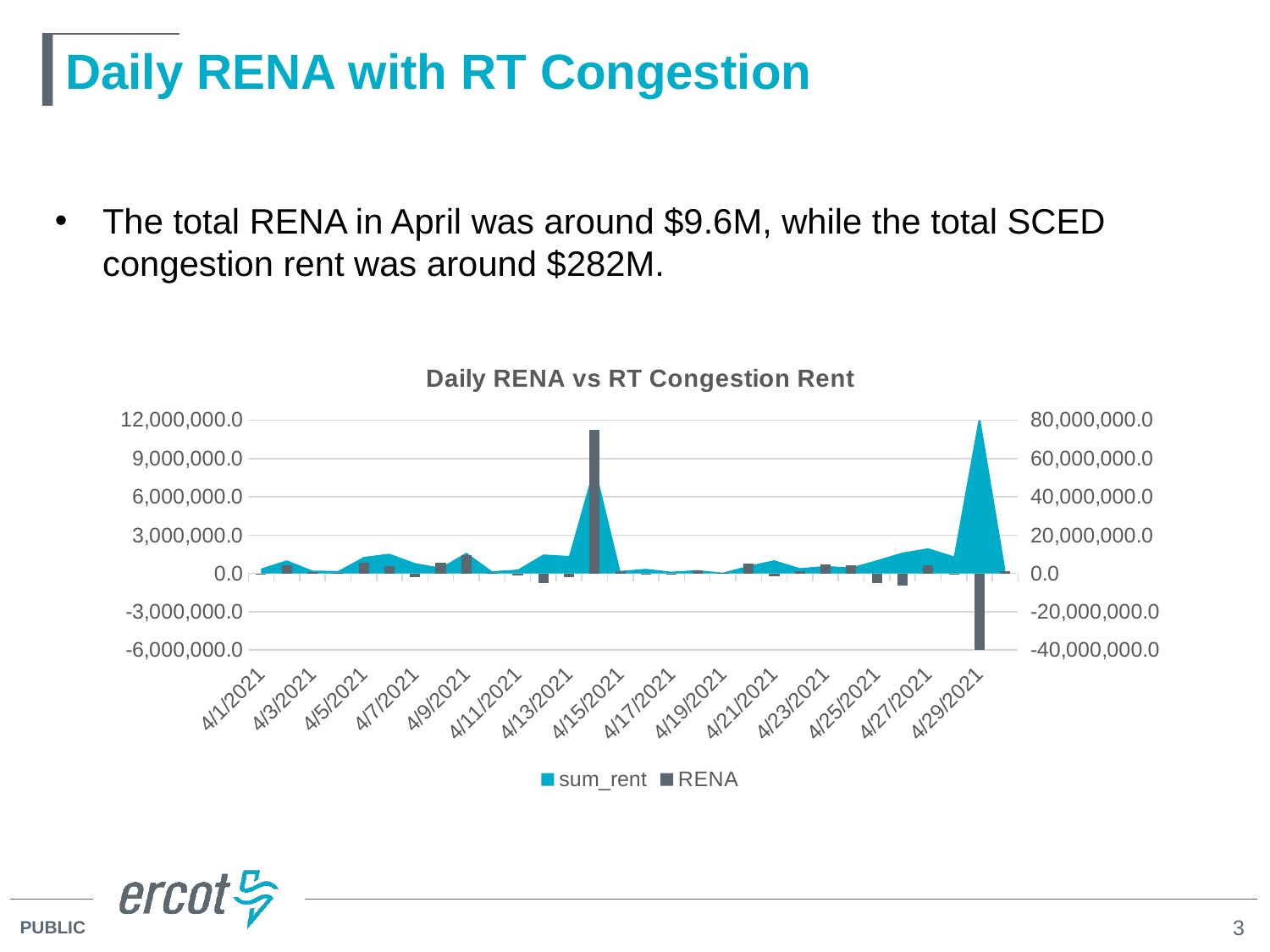
Between 4/25/2021 and 4/29/2021, does the sum_rent series overall rise or fall? rise Is the RENA value on 4/29/2021 greater or less than 0.0? less On which date is the RENA bar most negative? 4/29/2021 What is the first date label on the x axis? 4/1/2021 What kind of chart is this? Combination area and bar chart Which is larger, the sum_rent value on 4/29/2021 or on 4/1/2021? 4/29/2021 How many date labels are shown on the x axis? 15 How many series does the chart legend list? 2 Is the sum_rent value on 4/29/2021 greater or less than 0.0? greater On which date does the sum_rent series reach its highest value? 4/29/2021 What is the title of the chart? Daily RENA vs RT Congestion Rent What are the two series named in the chart legend? sum_rent and RENA